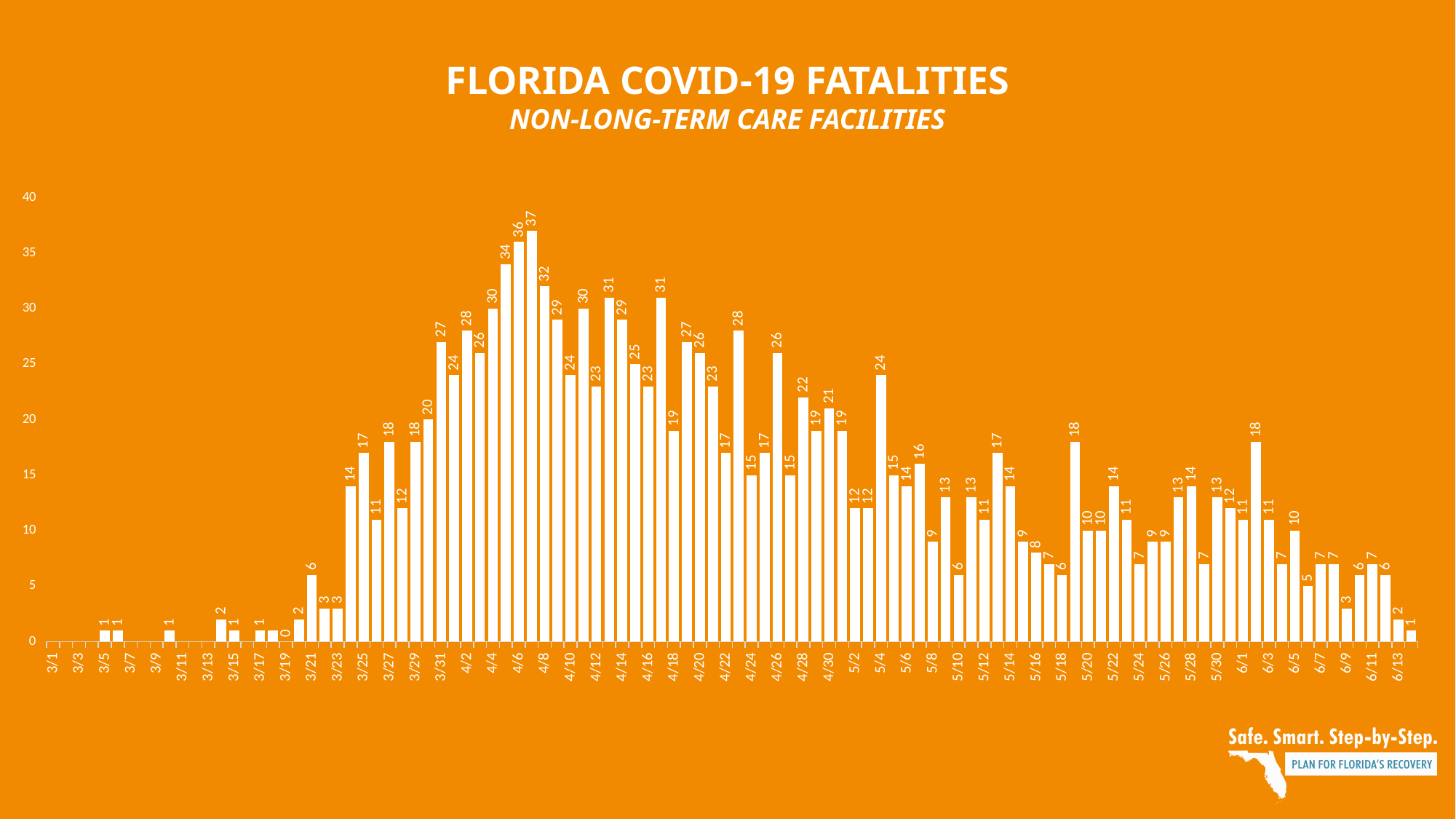
What is the highest value shown on the chart? 37 Do the values generally rise or fall from 4/8 to 6/13? fall What is the value for 3/21? 6 What is the value for 6/9? 3 What is the subtitle of the chart? NON-LONG-TERM CARE FACILITIES Is the value for 4/4 greater or less than 25? greater What is the difference between the values for 4/8 and 4/10? 8 What is the value for 5/4? 24 Which is larger, the value for 4/14 or the value for 5/14? 4/14 What type of chart is shown on the slide? bar chart What is the value for 4/6? 36 What is the title of the chart? FLORIDA COVID-19 FATALITIES